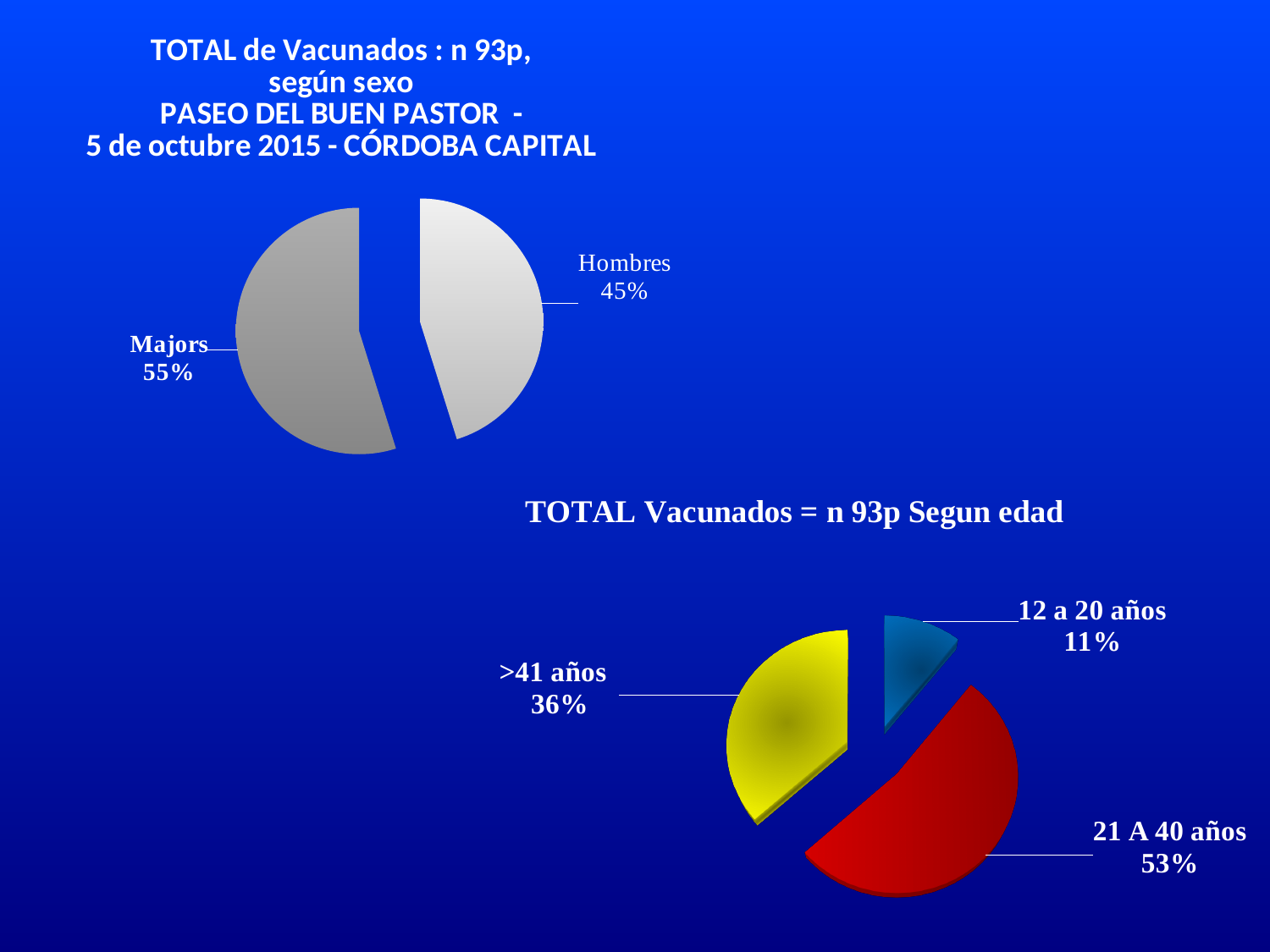
In the top pie chart (según sexo), what percentage is labelled for Hombres? 45% In the top pie chart (según sexo), what is the difference in percentage points between Majors and Hombres? 10 In the top pie chart (según sexo), what percentage is labelled for Majors? 55% In the top pie chart (según sexo), which slice is larger, Majors or Hombres? Majors In the bottom pie chart (Segun edad), which age group has the smallest share? 12 a 20 años In the bottom pie chart (Segun edad), what is the difference in percentage points between 21 A 40 años and >41 años? 17 In the bottom pie chart (Segun edad), which age group has the largest share? 21 A 40 años What kind of chart is the top chart (según sexo)? Pie chart In the bottom pie chart (Segun edad), what colour is the slice for >41 años? Yellow In the bottom pie chart (Segun edad), what percentage is labelled for >41 años? 36% In the top pie chart (según sexo), how many slices are there? 2 In the bottom pie chart (Segun edad), what percentage is labelled for 21 A 40 años? 53%